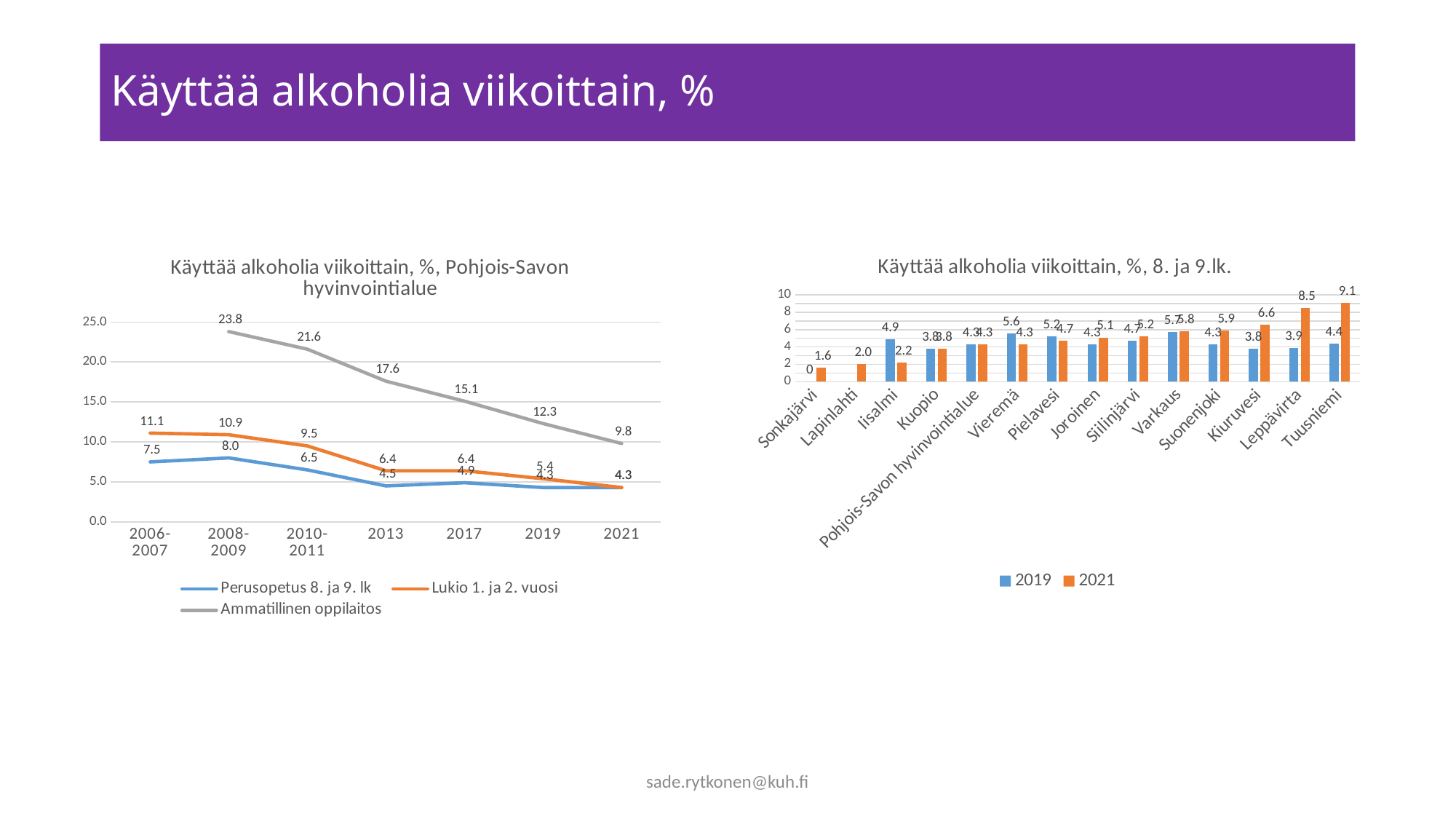
In the chart titled 'Käyttää alkoholia viikoittain, %, 8. ja 9.lk.', which category has the highest 2021 value? Tuusniemi In the chart titled 'Käyttää alkoholia viikoittain, %, Pohjois-Savon hyvinvointialue', does the Ammatillinen oppilaitos series rise or fall from 2008-2009 to 2021? fall In the chart titled 'Käyttää alkoholia viikoittain, %, Pohjois-Savon hyvinvointialue', what kind of chart is it? line chart In the chart titled 'Käyttää alkoholia viikoittain, %, 8. ja 9.lk.', how many categories are shown on the x axis? 14 In the chart titled 'Käyttää alkoholia viikoittain, %, Pohjois-Savon hyvinvointialue', what is the value for Lukio 1. ja 2. vuosi in 2013? 6.4 In the chart titled 'Käyttää alkoholia viikoittain, %, 8. ja 9.lk.', which is larger for Iisalmi: the 2019 value or the 2021 value? 2019 In the chart titled 'Käyttää alkoholia viikoittain, %, Pohjois-Savon hyvinvointialue', how many series does the legend list? 3 In the chart titled 'Käyttää alkoholia viikoittain, %, 8. ja 9.lk.', what is the 2021 value for Tuusniemi? 9.1 In the chart titled 'Käyttää alkoholia viikoittain, %, 8. ja 9.lk.', which category has the highest 2019 value? Varkaus In the chart titled 'Käyttää alkoholia viikoittain, %, Pohjois-Savon hyvinvointialue', what is the difference between the Ammatillinen oppilaitos and Perusopetus 8. ja 9. lk values in 2021? 5.5 In the chart titled 'Käyttää alkoholia viikoittain, %, 8. ja 9.lk.', what is the difference between the 2021 and 2019 values for Leppävirta? 4.6 In the chart titled 'Käyttää alkoholia viikoittain, %, Pohjois-Savon hyvinvointialue', what is the value for Ammatillinen oppilaitos in 2008-2009? 23.8